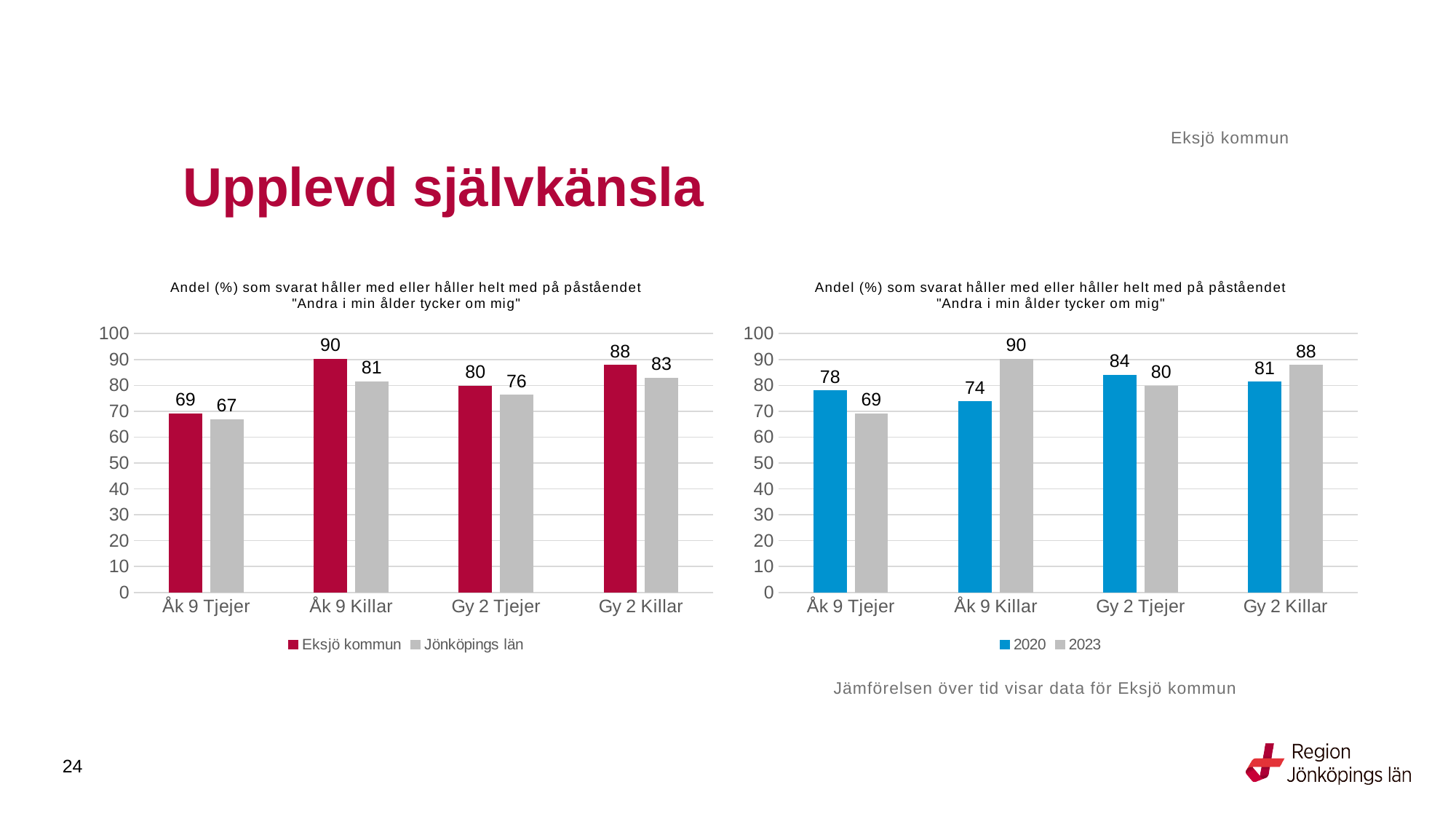
In the right chart, which is larger for Åk 9 Killar, the 2020 value or the 2023 value? 2023 How many categories are shown on the x axis of the right chart? 4 What type of chart is the left chart? Bar chart In the left chart, which category has the lowest value for Eksjö kommun? Åk 9 Tjejer In the right chart, what is the value for 2020 for Gy 2 Tjejer? 84 In the right chart, what is the difference between the 2023 and 2020 values for Gy 2 Killar? 7 In the right chart, which category has the highest value for 2023? Åk 9 Killar In the left chart, what is the value for Eksjö kommun for Åk 9 Killar? 90 In the left chart, how many series does the legend list? 2 In the left chart, what is the value for Jönköpings län for Gy 2 Tjejer? 76 In the left chart, what is the difference between Eksjö kommun and Jönköpings län for Åk 9 Killar? 9 In the right chart, what is the value for 2023 for Åk 9 Tjejer? 69